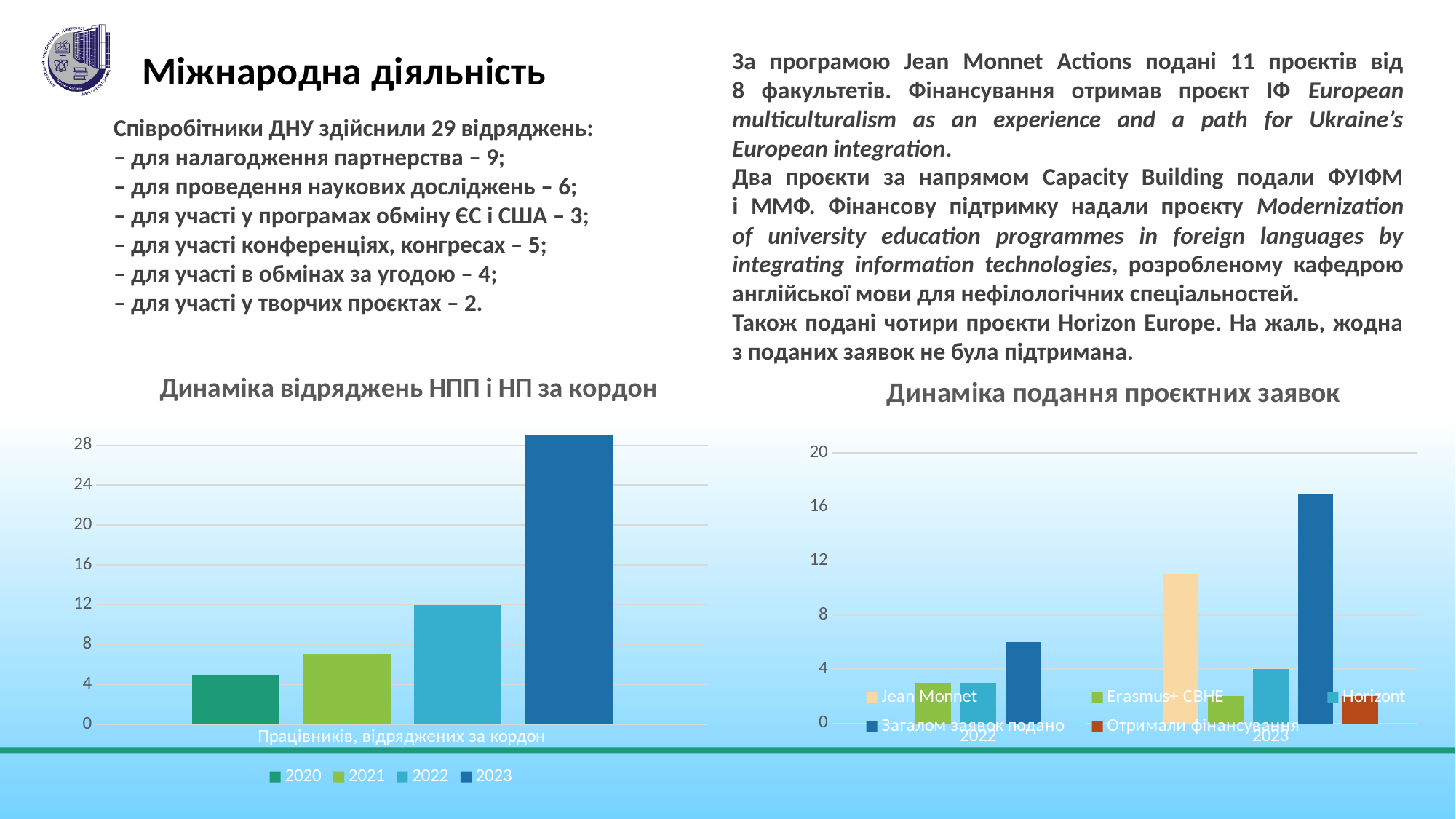
In the left chart "Динаміка відряджень НПП і НП за кордон", which year has the highest bar? 2023 What kind of chart is the left chart titled "Динаміка відряджень НПП і НП за кордон"? bar chart In the left chart "Динаміка відряджень НПП і НП за кордон", which is larger, the value for 2021 or the value for 2022? 2022 In the left chart "Динаміка відряджень НПП і НП за кордон", which year has the lowest bar? 2020 In the left chart "Динаміка відряджень НПП і НП за кордон", is the value for 2020 greater or less than 8? less In the right chart "Динаміка подання проєктних заявок", is the value of "Jean Monnet" for 2023 greater or less than 8? greater In the right chart "Динаміка подання проєктних заявок", how many series does the legend list? 5 In the left chart "Динаміка відряджень НПП і НП за кордон", how many series does the legend list? 4 In the right chart "Динаміка подання проєктних заявок", how many categories are shown on the x axis? 2 What kind of chart is the right chart titled "Динаміка подання проєктних заявок"? bar chart In the left chart "Динаміка відряджень НПП і НП за кордон", is the value for 2023 greater or less than 28? greater